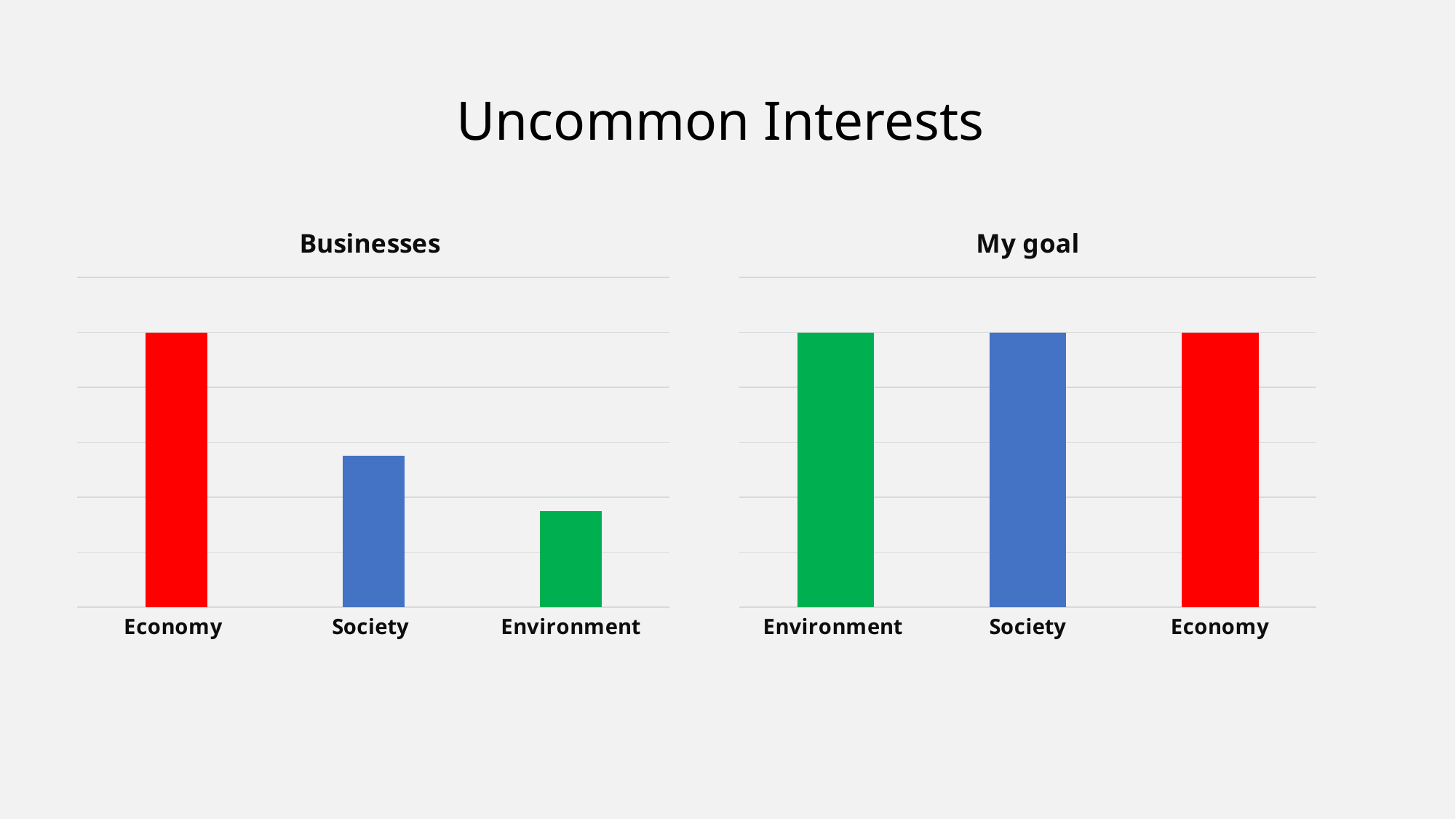
How many categories are shown in the My goal chart? 3 In the Businesses chart, do the values rise or fall from left to right along the x axis? fall What kind of chart is the Businesses chart? bar chart In the Businesses chart, which category has the highest bar? Economy What is the title of the chart on the right side of the slide? My goal In the Businesses chart, which is larger, the value for Society or the value for Environment? Society In the Businesses chart, which is larger, the value for Economy or the value for Society? Economy In the My goal chart, what colour is the Environment bar? green In the Businesses chart, which category has the lowest bar? Environment How many categories are shown in the Businesses chart? 3 What kind of chart is the My goal chart? bar chart